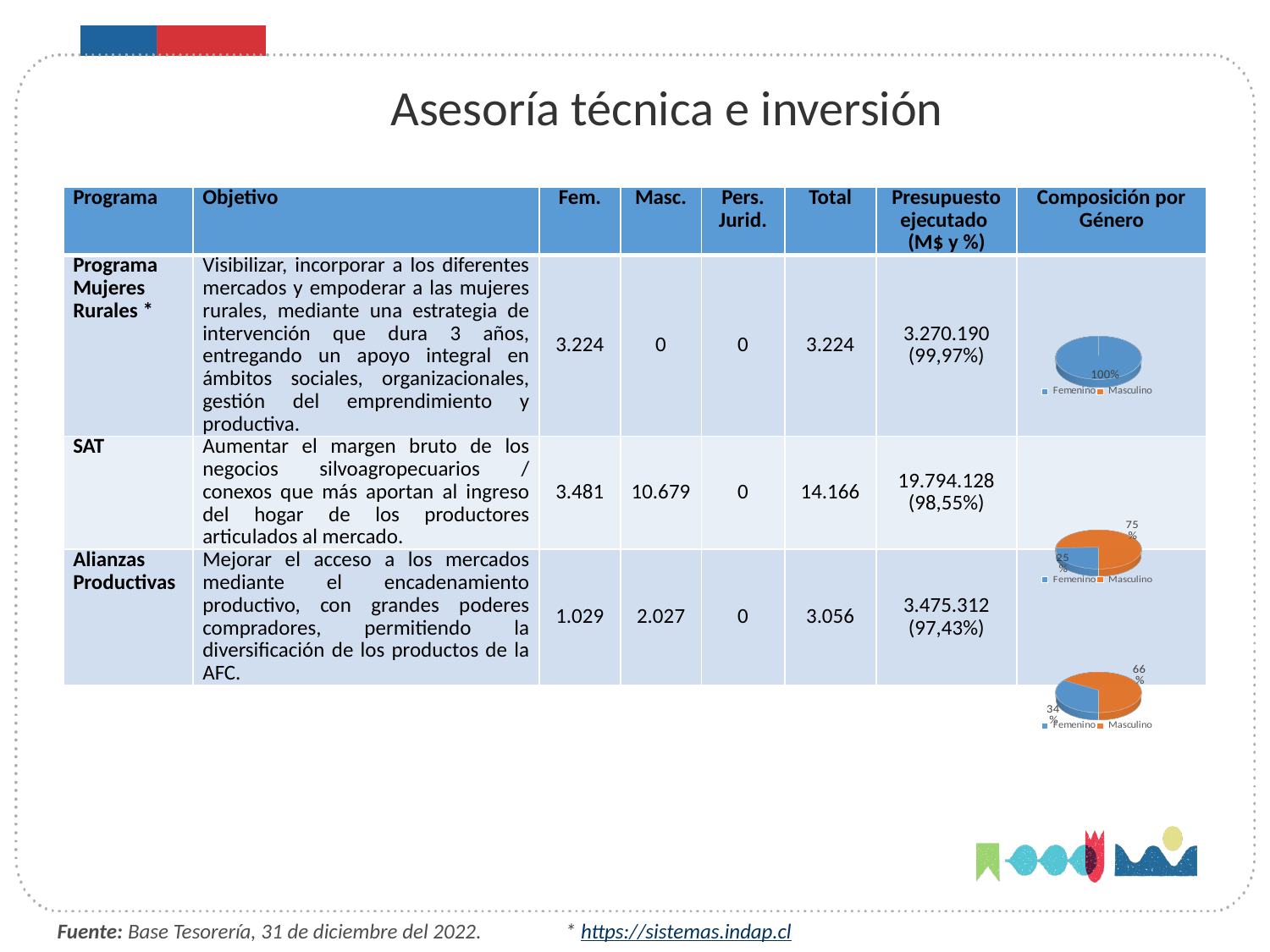
What kind of charts are shown in the 'Composición por Género' column? pie charts What are the two legend entries of the pie charts? Femenino, Masculino How many series does the legend of the top pie chart list? 2 In the bottom pie chart, what share is labelled on the Masculino slice? 66% In the bottom pie chart, what share is labelled on the Femenino slice? 34% Which colour represents Masculino in the pie charts? orange In the top pie chart, what share is labelled on the Femenino slice? 100% In the bottom pie chart, what is the difference between the Masculino and Femenino shares? 32% In the middle pie chart, which slice is larger, Femenino or Masculino? Masculino How many pie charts are shown on the slide? 3